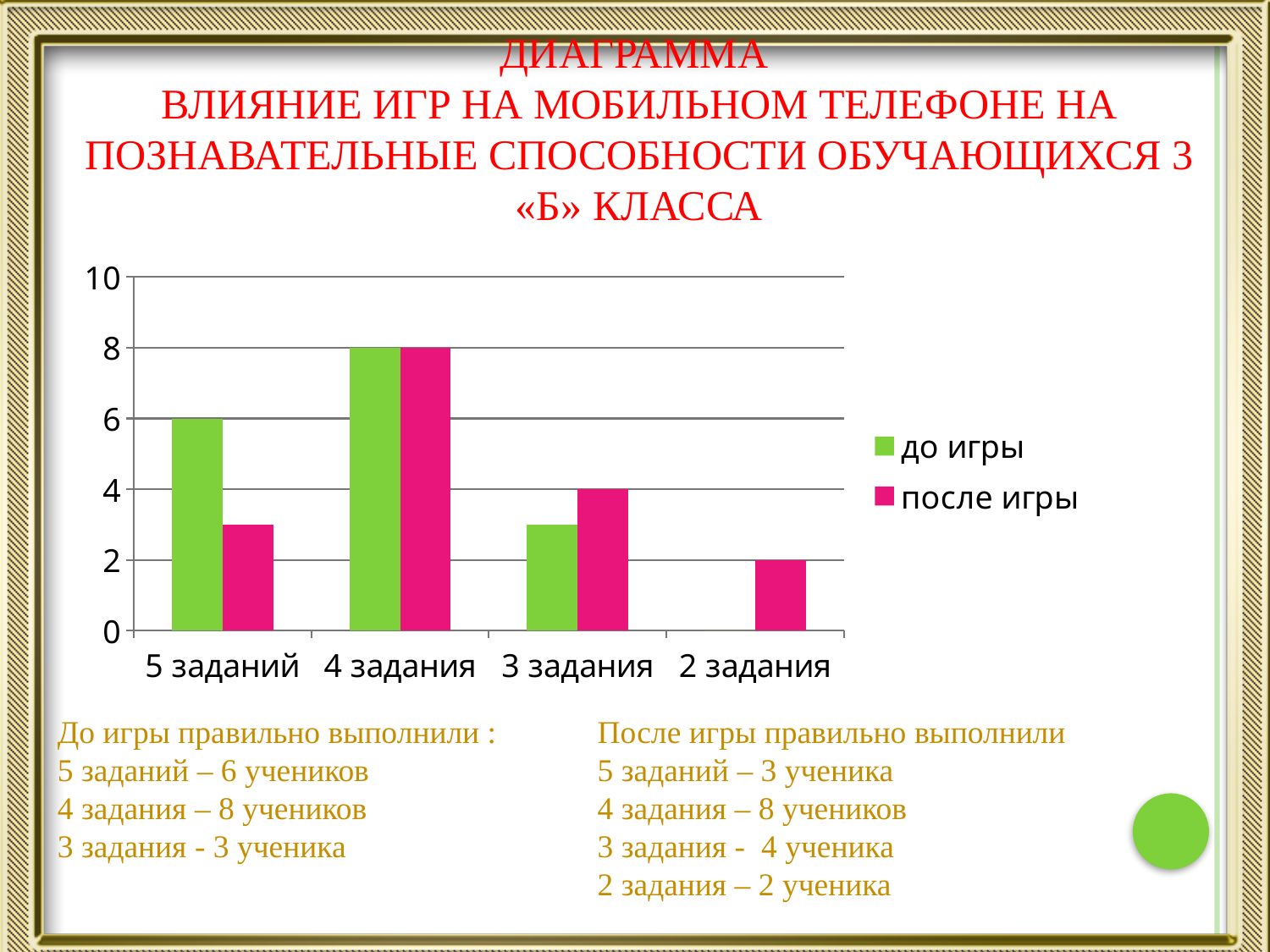
Which legend entry is shown in green? до игры What is the value for "5 заданий" in the "до игры" series? 6 What is the value for "2 задания" in the "после игры" series? 2 How many categories are shown on the x axis? 4 Which category has the highest value in the "до игры" series? 4 задания What kind of chart is shown on the slide? bar chart What is the value for "4 задания" in the "после игры" series? 8 Which category has the lowest value in the "после игры" series? 2 задания For "3 задания", which series has the larger value, "до игры" or "после игры"? после игры What is the value for "5 заданий" in the "после игры" series? 3 What is the difference between the "до игры" and "после игры" values for "5 заданий"? 3 How many series does the legend list? 2